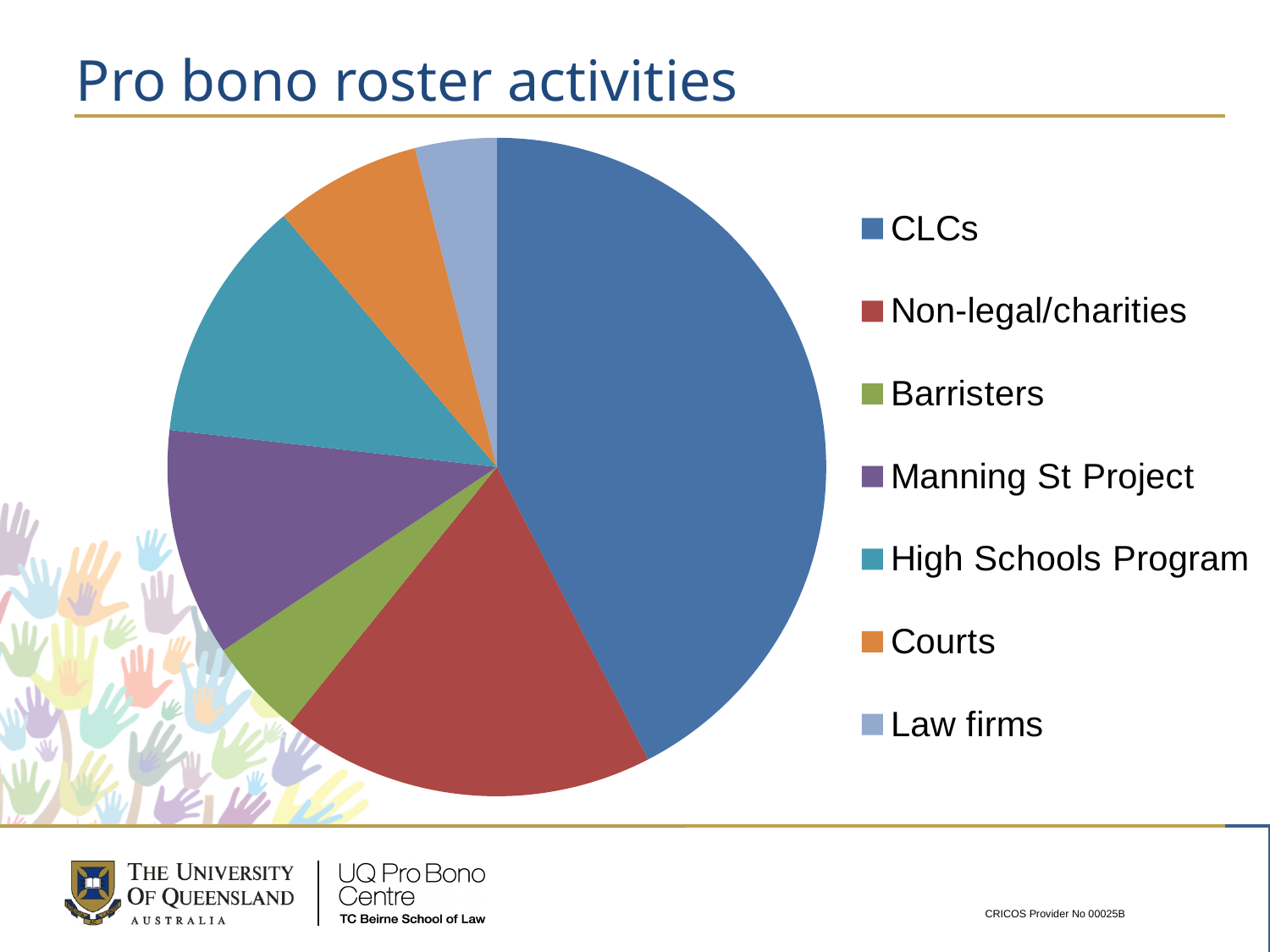
How many categories does the pie chart show? 7 Which category is the second largest slice of the pie? Non-legal/charities Which slice is larger, High Schools Program or Law firms? High Schools Program Which slice is larger, Manning St Project or Barristers? Manning St Project Which category has the largest slice of the pie? CLCs Which slice is larger, CLCs or Non-legal/charities? CLCs What colour is the CLCs slice in the pie chart? blue What is the title of the chart? Pro bono roster activities What kind of chart is shown on the slide? pie chart Which category has the smallest slice of the pie? Law firms